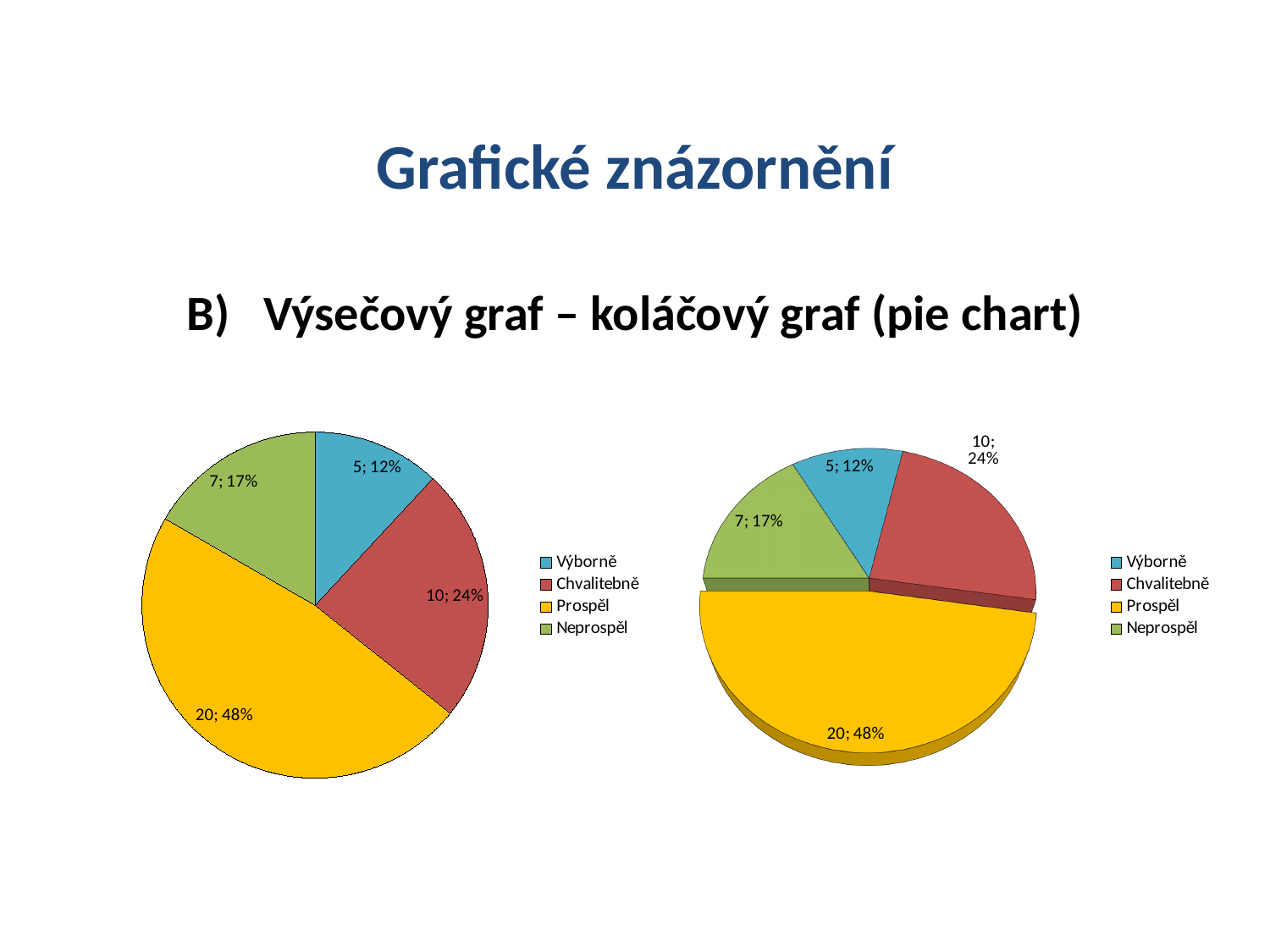
In the right pie chart, what value is shown for Neprospěl? 7; 17% In the right pie chart, what share of the pie does Prospěl take? 48% In the left pie chart, what value is shown for Prospěl? 20; 48% How many categories does the legend of the left pie chart list? 4 In the left pie chart, what value is shown for Výborně? 5; 12% What type of chart is shown on the right side of the slide? Pie chart In the right pie chart, which category has the smallest slice? Výborně In the right pie chart, which is larger, Chvalitebně or Neprospěl? Chvalitebně In the left pie chart, what share of the pie does Chvalitebně take? 24% In the right pie chart, what value is shown for Chvalitebně? 10; 24% In the left pie chart, which category has the largest slice? Prospěl In the left pie chart, what is the difference between the counts for Prospěl and Neprospěl? 13